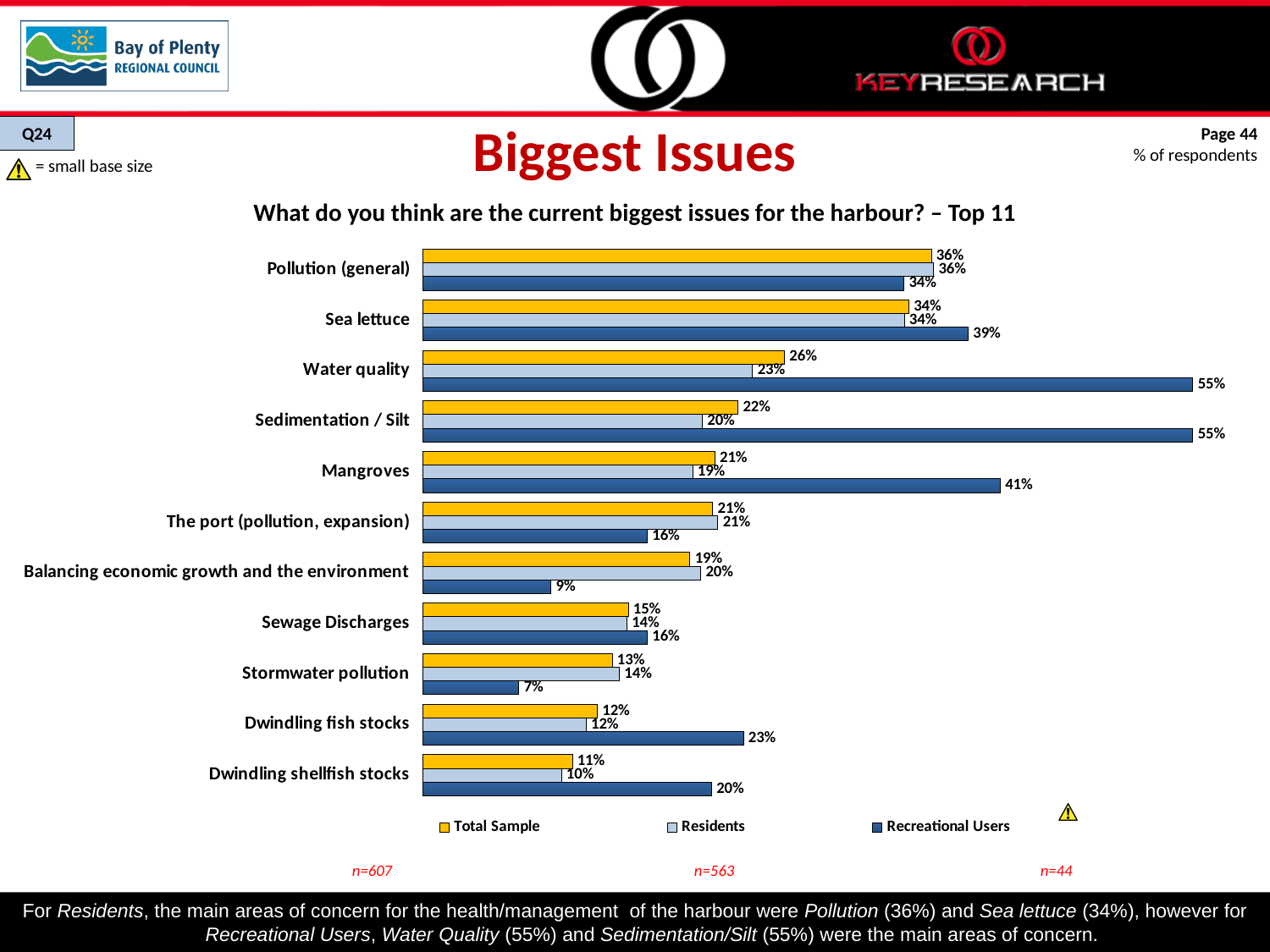
Which series is shown in dark blue in the legend? Recreational Users What is the difference between the Recreational Users and Residents values for Sedimentation / Silt? 35% Which issue has the lowest Recreational Users value? Stormwater pollution What type of chart is shown on the slide? bar chart What is the Residents value for Sea lettuce? 34% Which issue has the lowest Residents value? Dwindling shellfish stocks What is the Total Sample value for Mangroves? 21% How many series does the legend list? 3 What is the Recreational Users value for Water quality? 55% Which issue has the highest Total Sample value? Pollution (general) How many issue categories are plotted in the chart? 11 For Balancing economic growth and the environment, which is larger: the Residents value or the Recreational Users value? Residents